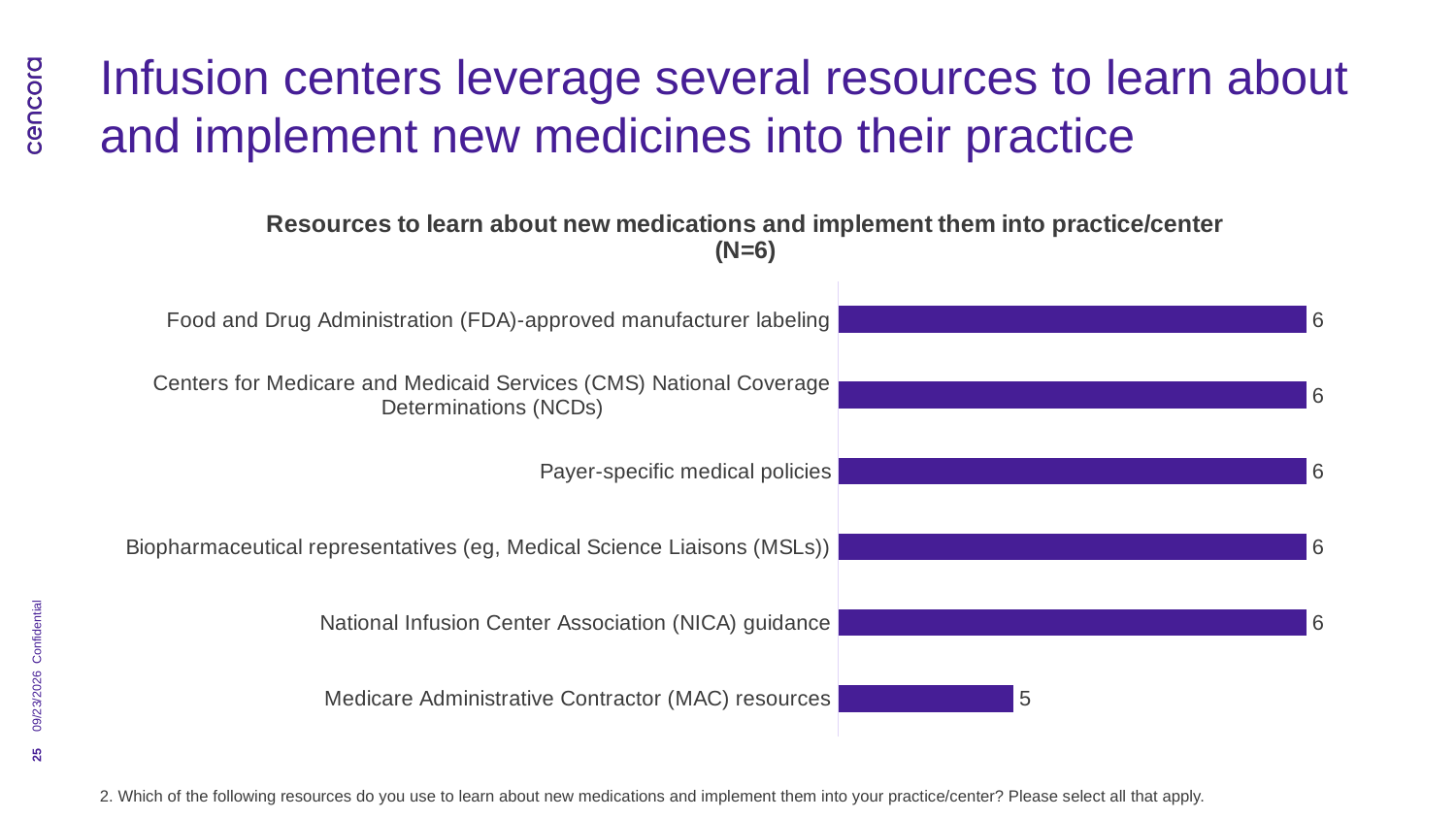
What colour are the bars in the chart? Purple What is the title of the chart? Resources to learn about new medications and implement them into practice/center (N=6) Which category has the lowest value? Medicare Administrative Contractor (MAC) resources What is the value for Payer-specific medical policies? 6 What is the difference between the value for Food and Drug Administration (FDA)-approved manufacturer labeling and the value for Medicare Administrative Contractor (MAC) resources? 1 What is the value for Medicare Administrative Contractor (MAC) resources? 5 What is the value for National Infusion Center Association (NICA) guidance? 6 How many categories have a value of 6? 5 Which is larger: the value for Biopharmaceutical representatives (eg, Medical Science Liaisons (MSLs)) or the value for Medicare Administrative Contractor (MAC) resources? Biopharmaceutical representatives (eg, Medical Science Liaisons (MSLs)) How many categories are shown in the chart? 6 What kind of chart is shown on the slide? Bar chart